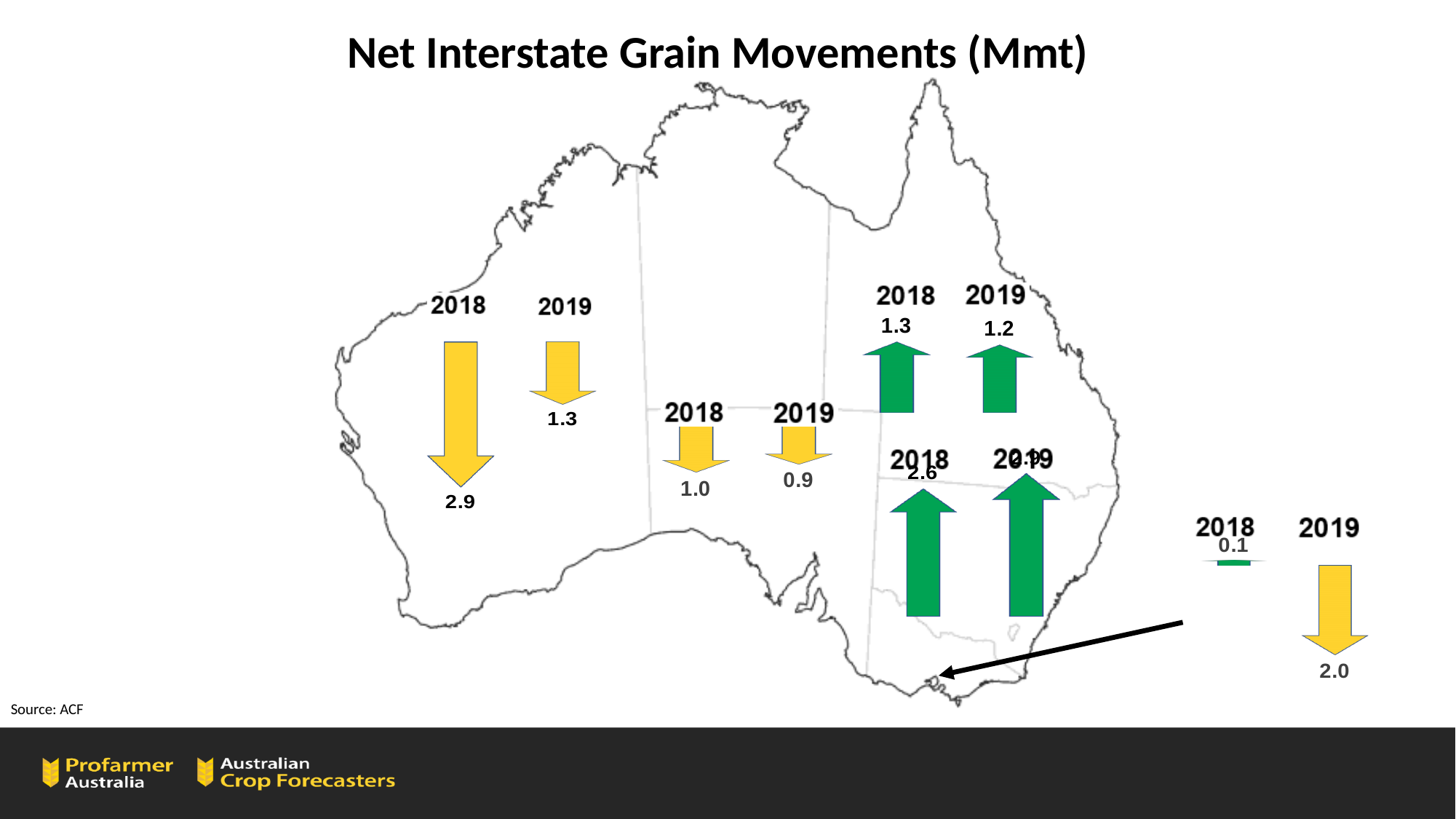
What is the 2018 value shown by the large downward arrow on the western (leftmost) part of the map? 2.9 What colour are the downward-pointing arrows on the map? Yellow What is the 2019 value shown by the downward arrow on the western (leftmost) part of the map? 1.3 Which is larger: the 2018 value for the western (leftmost) state or the 2018 value for the lower-right (south-eastern) state? The western (leftmost) state By how much does the western (leftmost) state's value fall from 2018 (2.9) to 2019 (1.3)? 1.6 What is the 2019 value shown by the downward arrow in the centre of the map? 0.9 What is the title of the map chart on the slide? Net Interstate Grain Movements (Mmt) What is the 2018 value shown by the downward arrow in the centre of the map? 1.0 What is the 2019 value shown by the downward arrow to the right of the map, linked by a black line to the southern tip of the mainland? 2.0 What is the 2018 value shown by the upward arrow in the upper-right (north-eastern) part of the map? 1.3 What is the 2019 value shown by the upward arrow in the upper-right (north-eastern) part of the map? 1.2 What is the 2018 value shown by the upward arrow in the lower-right (south-eastern) part of the map? 2.6